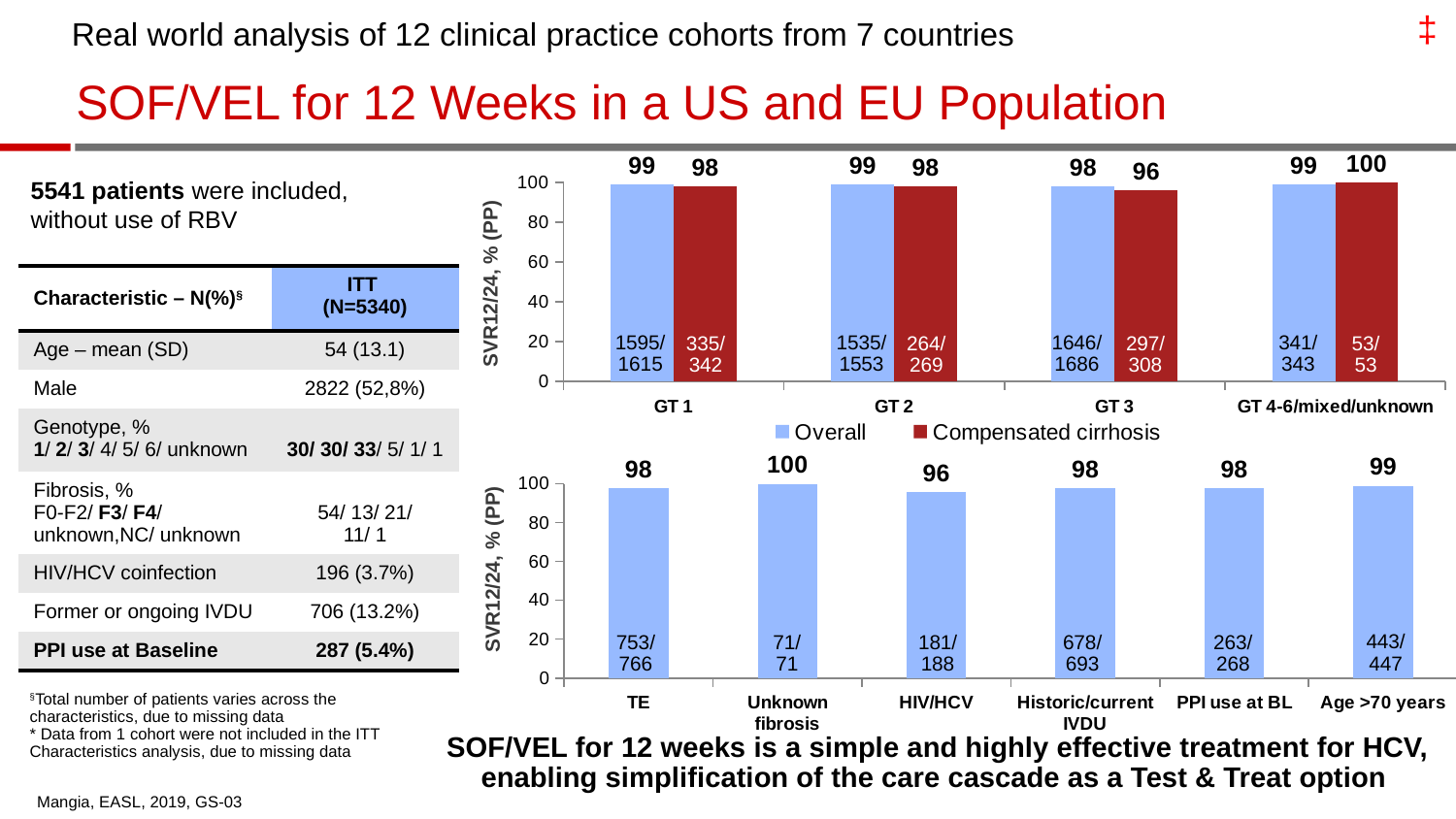
In the top chart, which is larger: the Compensated cirrhosis value for GT 1 or for GT 3? GT 1 In the bottom chart, which category has the highest SVR12/24 value? Unknown fibrosis What is the y-axis label of the top chart? SVR12/24, % (PP) In the top chart, what is the Compensated cirrhosis value for GT 4-6/mixed/unknown? 100 How many categories are shown in the bottom chart? 6 In the bottom chart, which category has the lowest SVR12/24 value? HIV/HCV In the top chart, what is the difference between the Overall and Compensated cirrhosis values for GT 3? 2 What type of chart is the bottom chart? bar chart In the bottom chart, what is the SVR12/24 value for Age >70 years? 99 In the top chart, what is the Overall SVR12/24 value for GT 3? 98 How many series does the legend of the top chart list? 2 In the bottom chart, what is the difference between the values for Unknown fibrosis and HIV/HCV? 4